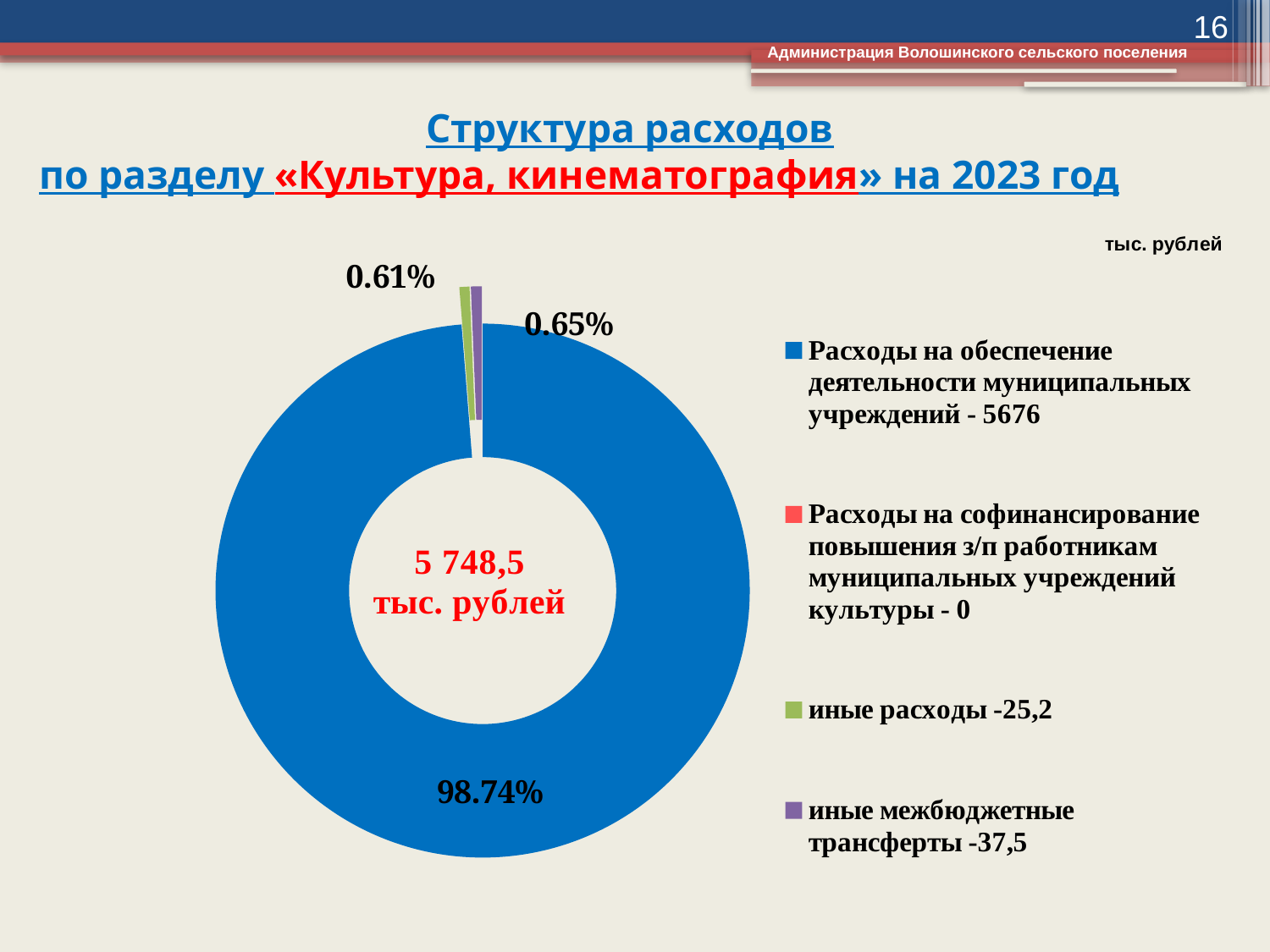
What value is given in the legend for «иные межбюджетные трансферты»? 37,5 What value (тыс. рублей) is given in the legend for «Расходы на обеспечение деятельности муниципальных учреждений»? 5676 What share of the chart does the slice for «иные расходы» represent? 0.61% Which is larger: the value for «иные межбюджетные трансферты» or the value for «иные расходы»? иные межбюджетные трансферты What share of the chart does the slice for «иные межбюджетные трансферты» represent? 0.65% What total amount is shown in the centre of the chart? 5 748,5 тыс. рублей What value is given in the legend for «Расходы на софинансирование повышения з/п работникам муниципальных учреждений культуры»? 0 What value is given in the legend for «иные расходы»? 25,2 What share of the chart does the slice for «Расходы на обеспечение деятельности муниципальных учреждений» represent? 98.74% What kind of chart is shown on the slide? doughnut (pie) chart How many entries does the legend list? 4 Which category has the largest share of the chart? Расходы на обеспечение деятельности муниципальных учреждений